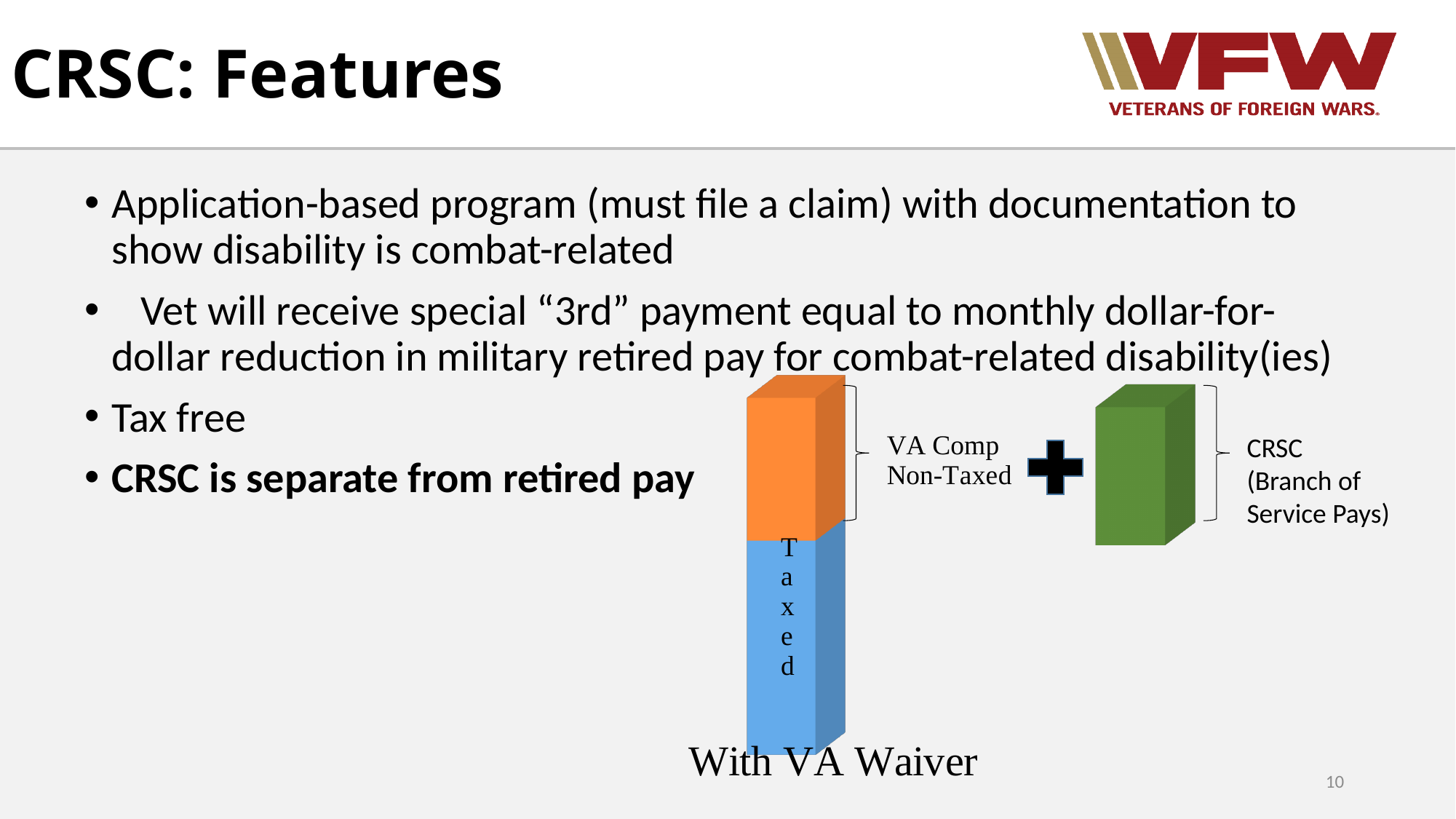
How many segments make up the stacked bar labelled With VA Waiver? 2 In the diagram, which segment of the stacked bar is taller, the Taxed segment or the VA Comp Non-Taxed segment? Taxed What label appears beneath the stacked bar in the diagram? With VA Waiver What does the green block in the diagram represent? CRSC (Branch of Service Pays)